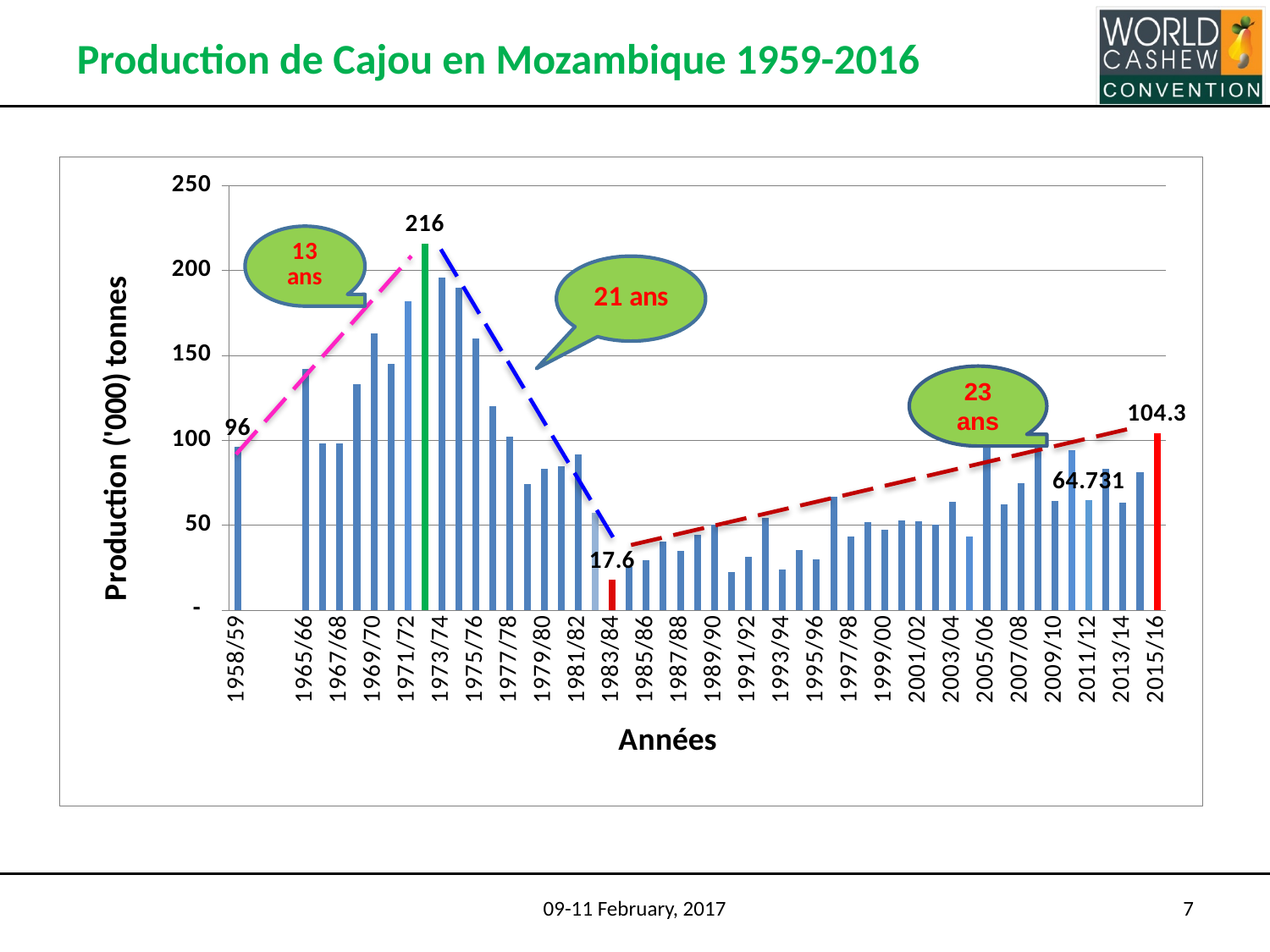
What is the production value for 2015/16? 104.3 What is the title of the y axis? Production ('000) tonnes What is the production value for 1958/59? 96 Which year has the lowest production bar? 1983/84 What is the difference between the green bar's value and the 1983/84 value? 198.4 What is the production value for 1983/84? 17.6 Which is larger, the production in 2015/16 or in 1958/59? 2015/16 What is the difference between the production in 2015/16 and in 1958/59? 8.3 What value is labelled on the green bar? 216 What is the highest production value labelled on the chart? 216 Is the value for 1973/74 greater or less than 150? greater What kind of chart is shown on the slide? bar chart